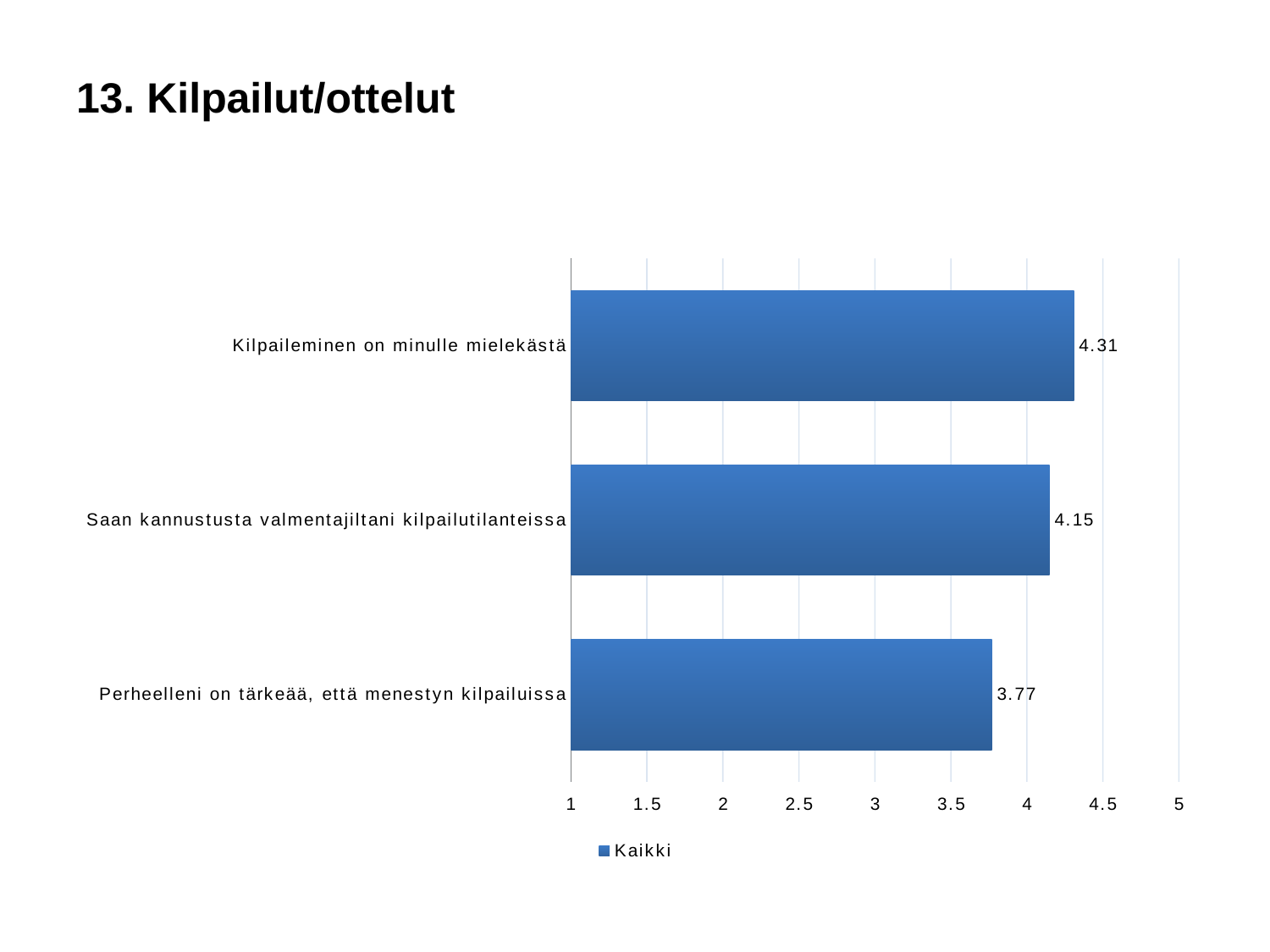
How many series does the legend list? 1 Which category has the highest value? Kilpaileminen on minulle mielekästä What is the difference between the values for "Kilpaileminen on minulle mielekästä" and "Saan kannustusta valmentajiltani kilpailutilanteissa"? 0.16 Which category has the lowest value? Perheelleni on tärkeää, että menestyn kilpailuissa Is the value for "Perheelleni on tärkeää, että menestyn kilpailuissa" greater or less than 4? less Which is larger: the value for "Saan kannustusta valmentajiltani kilpailutilanteissa" or for "Perheelleni on tärkeää, että menestyn kilpailuissa"? Saan kannustusta valmentajiltani kilpailutilanteissa What is the value for "Saan kannustusta valmentajiltani kilpailutilanteissa"? 4.15 What is the value for "Perheelleni on tärkeää, että menestyn kilpailuissa"? 3.77 What kind of chart is shown on the slide? Bar chart How many categories are shown in the chart? 3 What is the value for "Kilpaileminen on minulle mielekästä"? 4.31 What is the difference between the values for "Kilpaileminen on minulle mielekästä" and "Perheelleni on tärkeää, että menestyn kilpailuissa"? 0.54